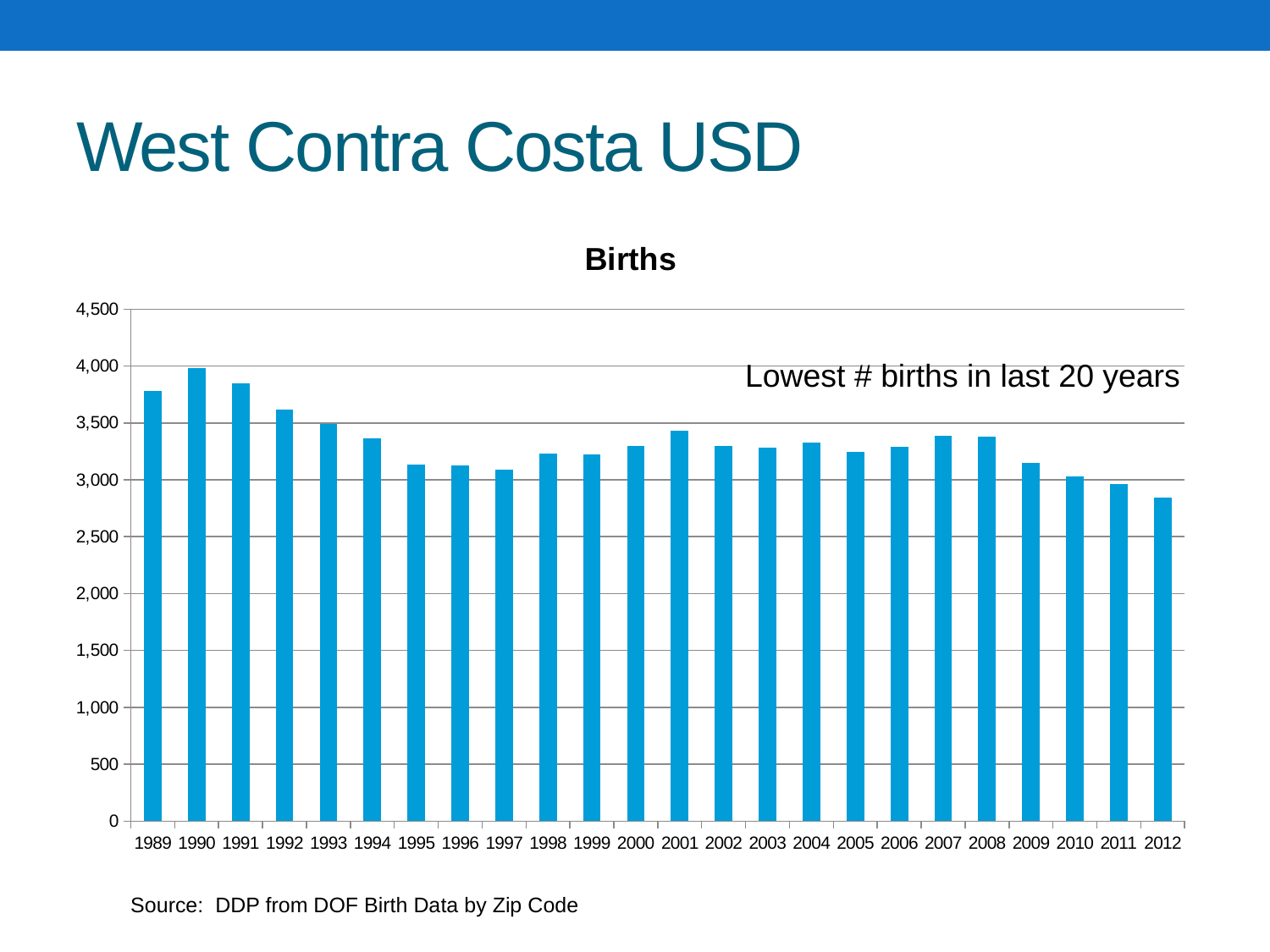
How many years are shown on the x axis? 24 What is the title of the chart? Births Overall, do births rise or fall from 1989 to 2012? fall Is the value for 1994 greater or less than 3,000? greater What does the annotation text on the chart say? Lowest # births in last 20 years Which year has the highest number of births? 1990 Is the value for 2012 greater or less than 3,000? less Which year has more births, 1992 or 1994? 1992 What kind of chart is shown on the slide? bar chart Is the value for 1990 greater or less than 3,500? greater Which year has the lowest number of births? 2012